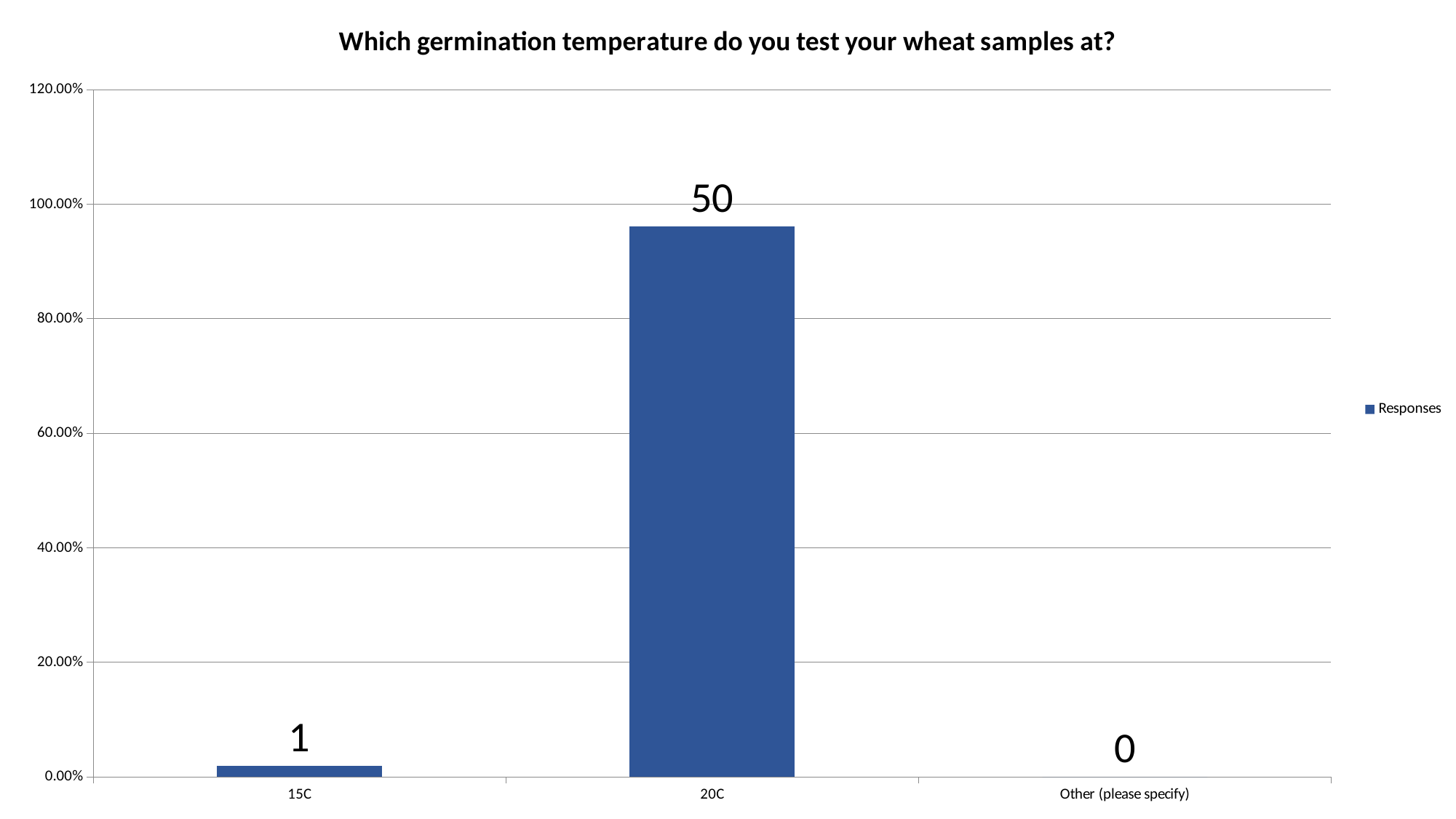
What is the difference between the data labels for 20C and 15C? 49 What is the data label shown for 15C? 1 Which category has the lowest value? Other (please specify) Which is larger, the value for 15C or the value for 20C? 20C What is the data label shown for Other (please specify)? 0 Is the bar for 20C greater or less than 80.00% on the axis? greater How many series does the legend list? 1 What kind of chart is this? Bar chart Is the bar for 15C greater or less than 20.00% on the axis? less What is the data label shown for 20C? 50 Which category has the highest value? 20C How many categories are shown on the x axis? 3